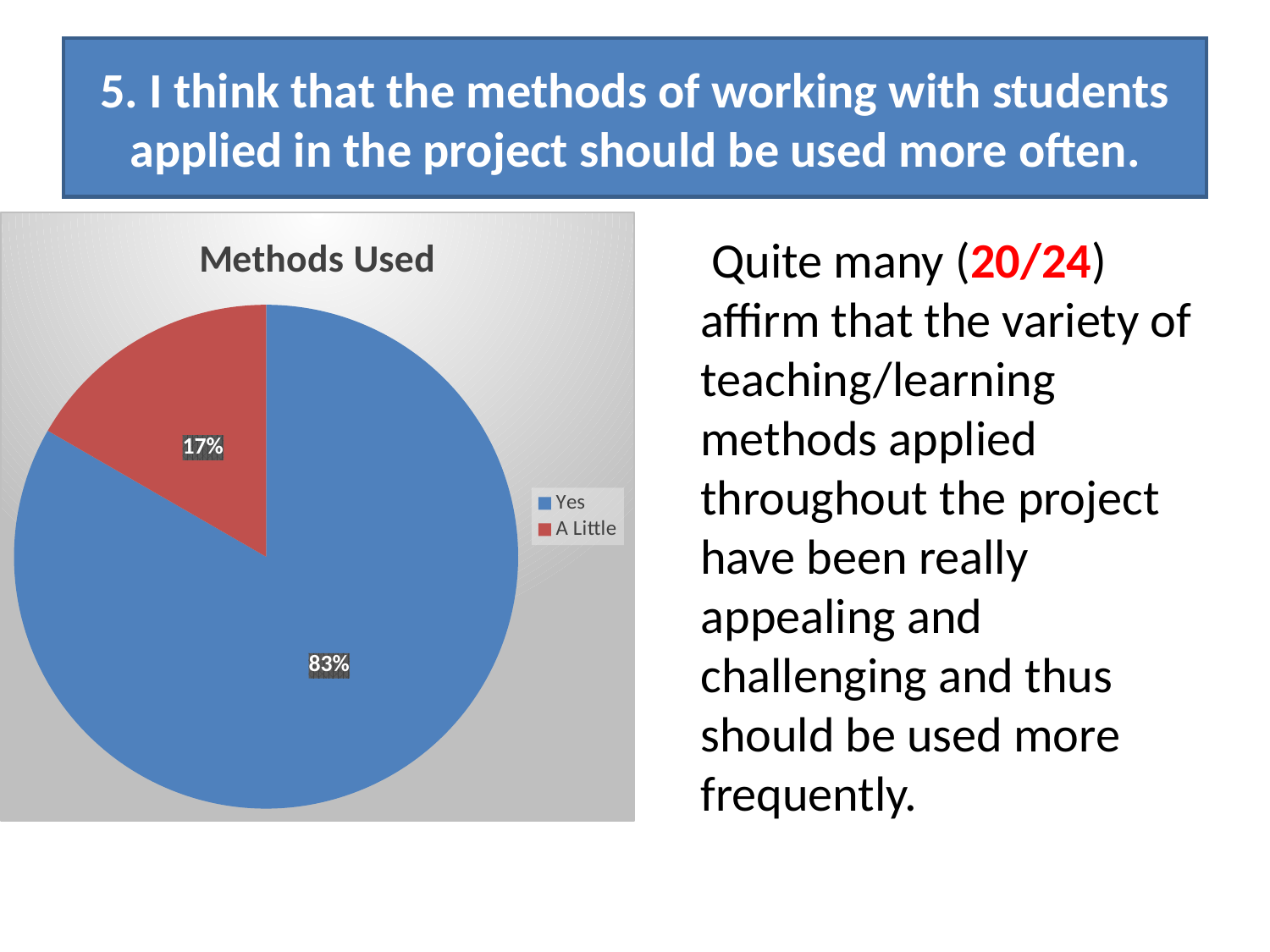
How many entries does the legend list? 2 What share of the pie does the "A Little" slice represent? 17% Which category has the smallest slice of the pie? A Little What share of the pie does the "Yes" slice represent? 83% What colour is the "A Little" slice in the pie chart? red What is the difference in percentage points between the "Yes" and "A Little" slices? 66 What kind of chart is shown on the slide? pie chart Which category has the largest slice of the pie? Yes How many categories does the pie chart show? 2 Which slice is larger, "Yes" or "A Little"? Yes What is the title of the chart? Methods Used